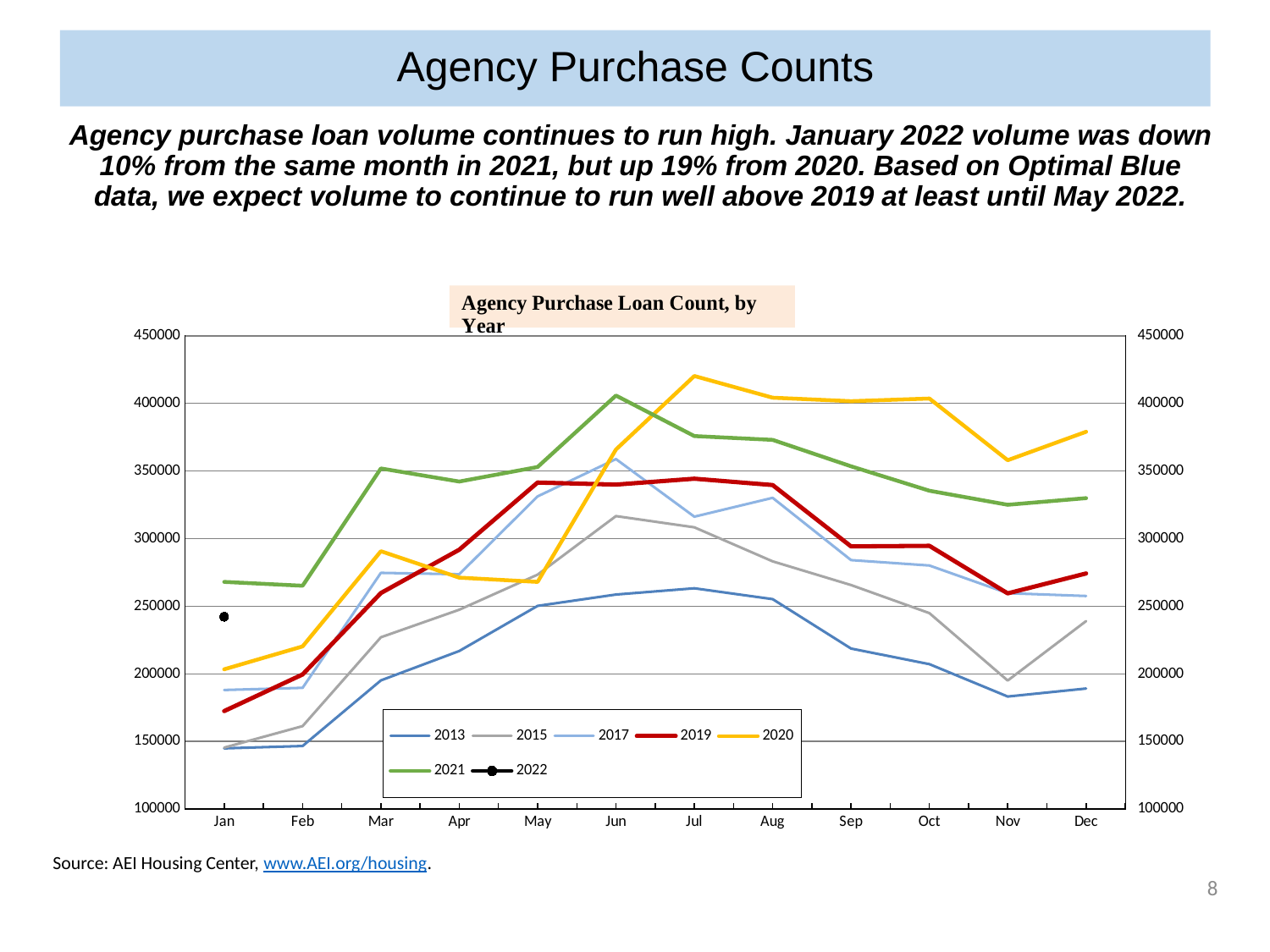
Is the value for 2013 in Jan greater or less than 150000? less How many series does the chart legend list? 7 Is the value for 2020 in Jul greater or less than 400000? greater Which is larger in Jan: the value for 2021 or the value for 2022? 2021 In which month does the 2020 series reach its highest value? Jul Which series in the chart is plotted as a single point rather than a line? 2022 How many months are shown along the x axis of the chart? 12 What is the title of the chart? Agency Purchase Loan Count, by Year Which series has the highest value in Jun? 2021 Is the value for 2021 in Nov greater or less than 300000? greater Which series has the lowest value in Dec? 2013 What type of chart is shown on the slide? line chart